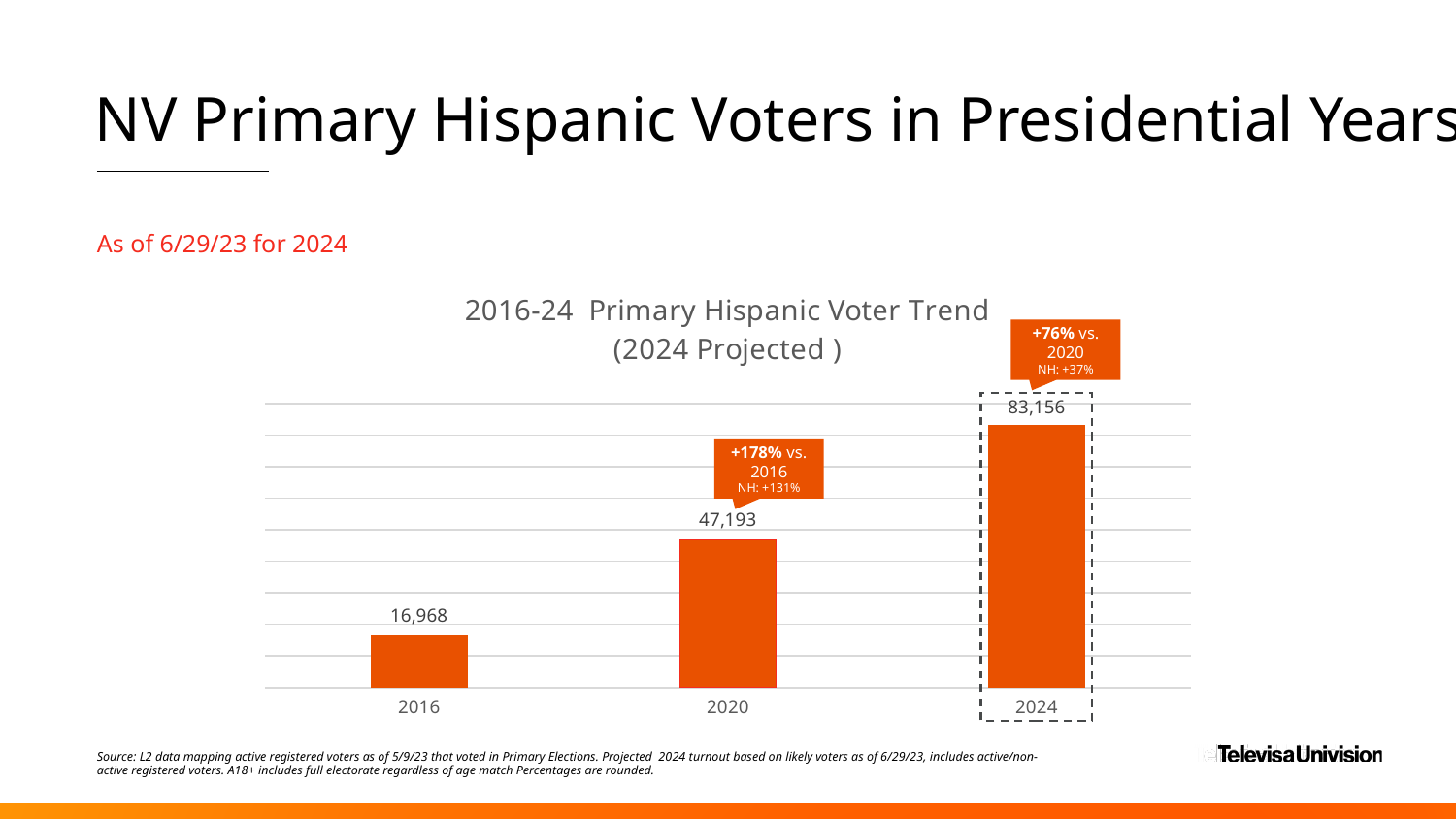
Which year has the lowest value? 2016 What is the projected value for 2024? 83,156 How many years are shown on the x axis? 3 Which is larger, the value for 2020 or the value for 2016? 2020 Which year has the highest value? 2024 What percentage change vs. 2020 does the callout above the 2024 bar show? +76% What is the difference between the 2024 and 2020 values? 35,963 What is the value for 2016? 16,968 What kind of chart is this? bar chart What is the difference between the 2020 and 2016 values? 30,225 Do the values rise or fall from 2016 to 2024? rise What is the value for 2020? 47,193